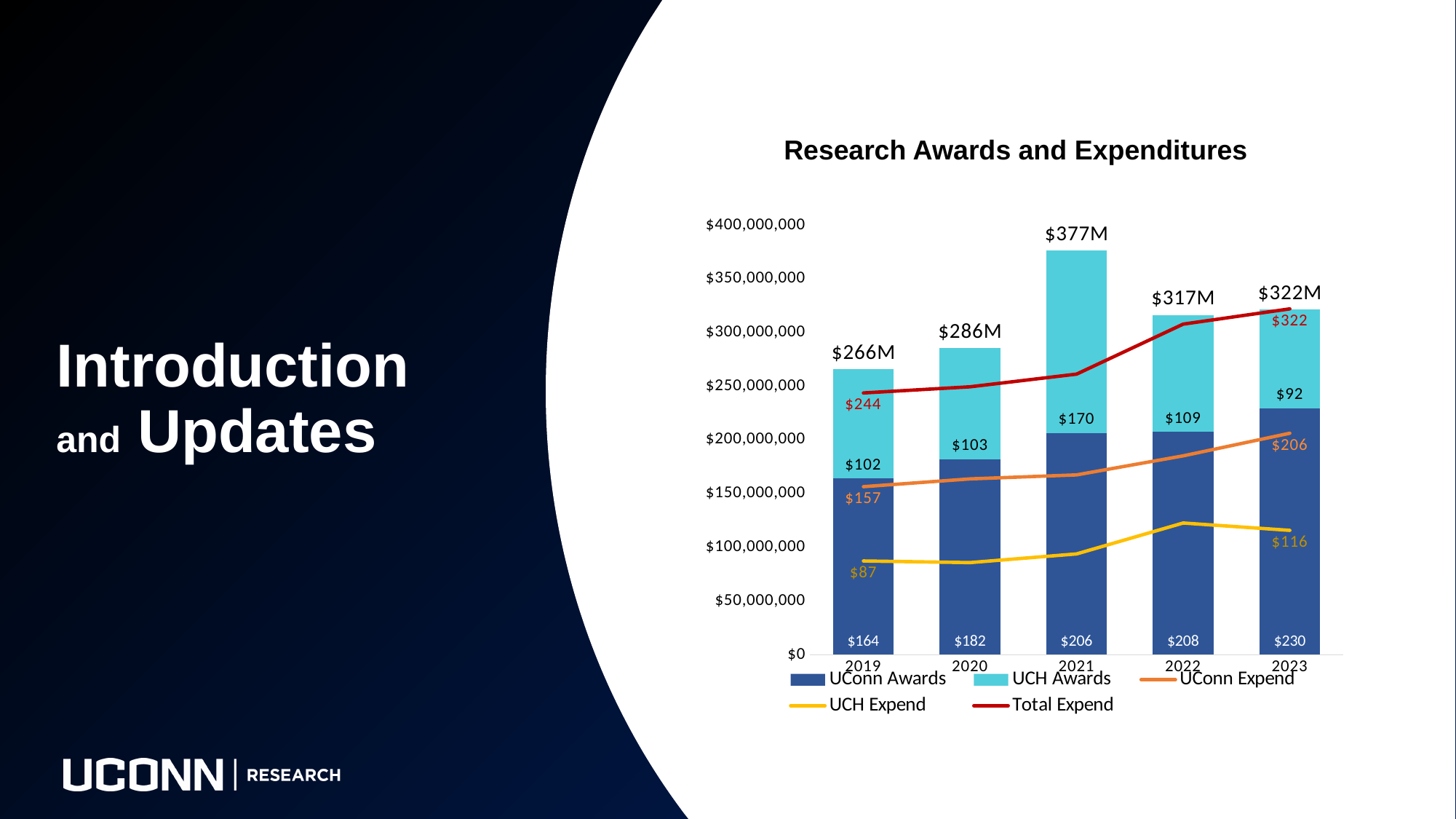
How many series does the legend list? 5 What is the difference between UConn Awards in 2023 and in 2019? $66 Is the UCH Expend value for 2022 greater or less than $100,000,000? greater Do the UConn Awards values rise or fall from 2019 to 2023? rise What is the value of UCH Awards for 2023? $92 What is the value of Total Expend for 2023? $322 Which year has the highest total awards bar? 2021 What is the value of UConn Awards for 2021? $206 How many years are shown on the x axis? 5 What is the total of the stacked bar for 2022? $317M Which year has the larger UCH Awards value, 2021 or 2022? 2021 What is the value of UConn Expend for 2019? $157